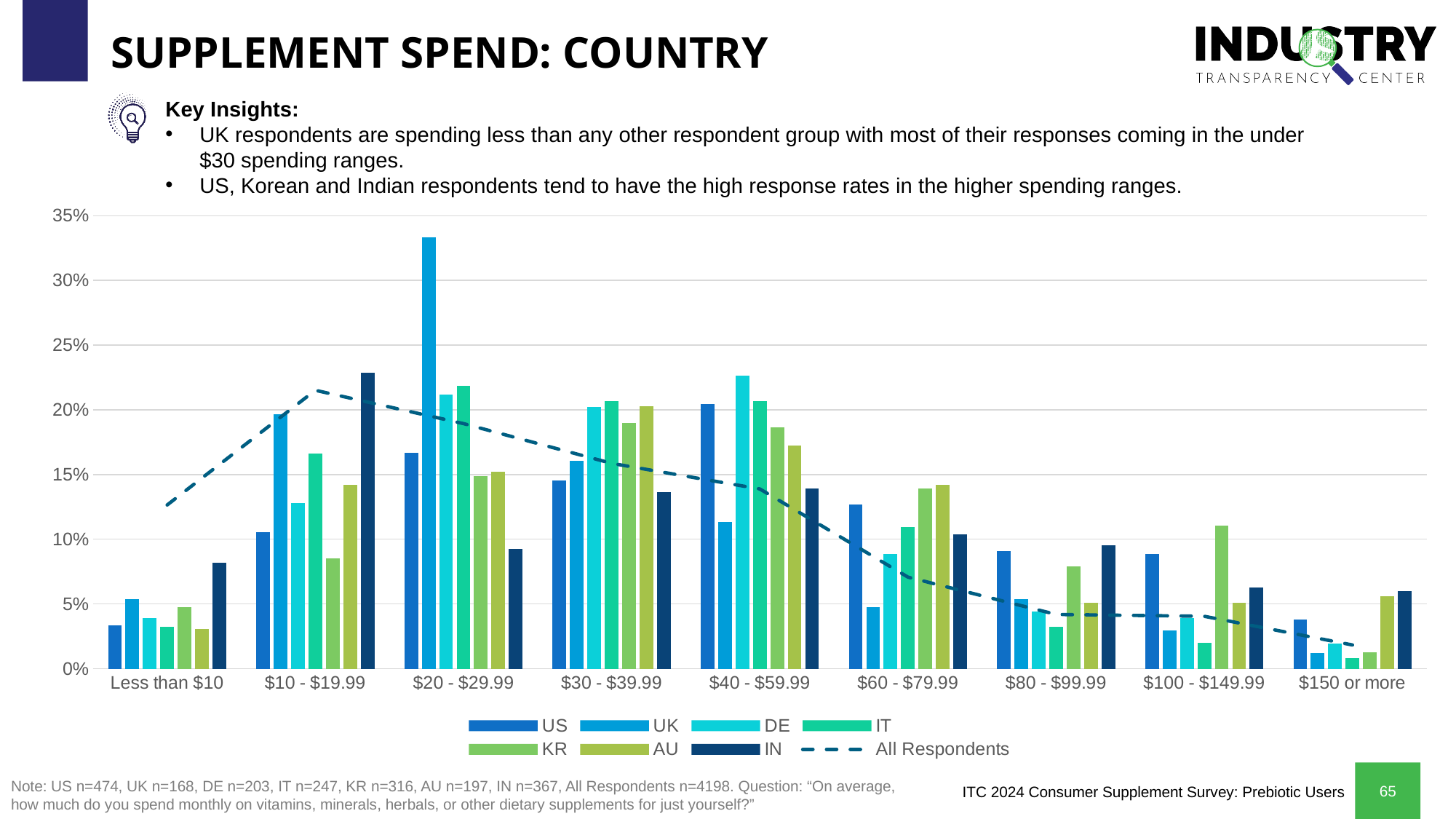
Is the value for UK in the $150 or more category greater or less than 5%? less What kind of chart is shown on the slide? combination bar and line chart Which country has the lowest bar in the $60 - $79.99 category? UK Is the value for DE in the $40 - $59.99 category greater or less than 20%? greater Is the value for UK in the $20 - $29.99 category greater or less than 30%? greater What does the dashed line in the chart represent, according to the legend? All Respondents How many series does the legend list? 8 Does the All Respondents dashed line rise or fall from $20 - $29.99 to $150 or more? fall Which country has the highest bar in the $10 - $19.99 category? IN In the $60 - $79.99 category, which is larger, the US bar or the UK bar? US How many spending-range categories are shown on the x axis? 9 Which country has the highest bar in the $20 - $29.99 category? UK